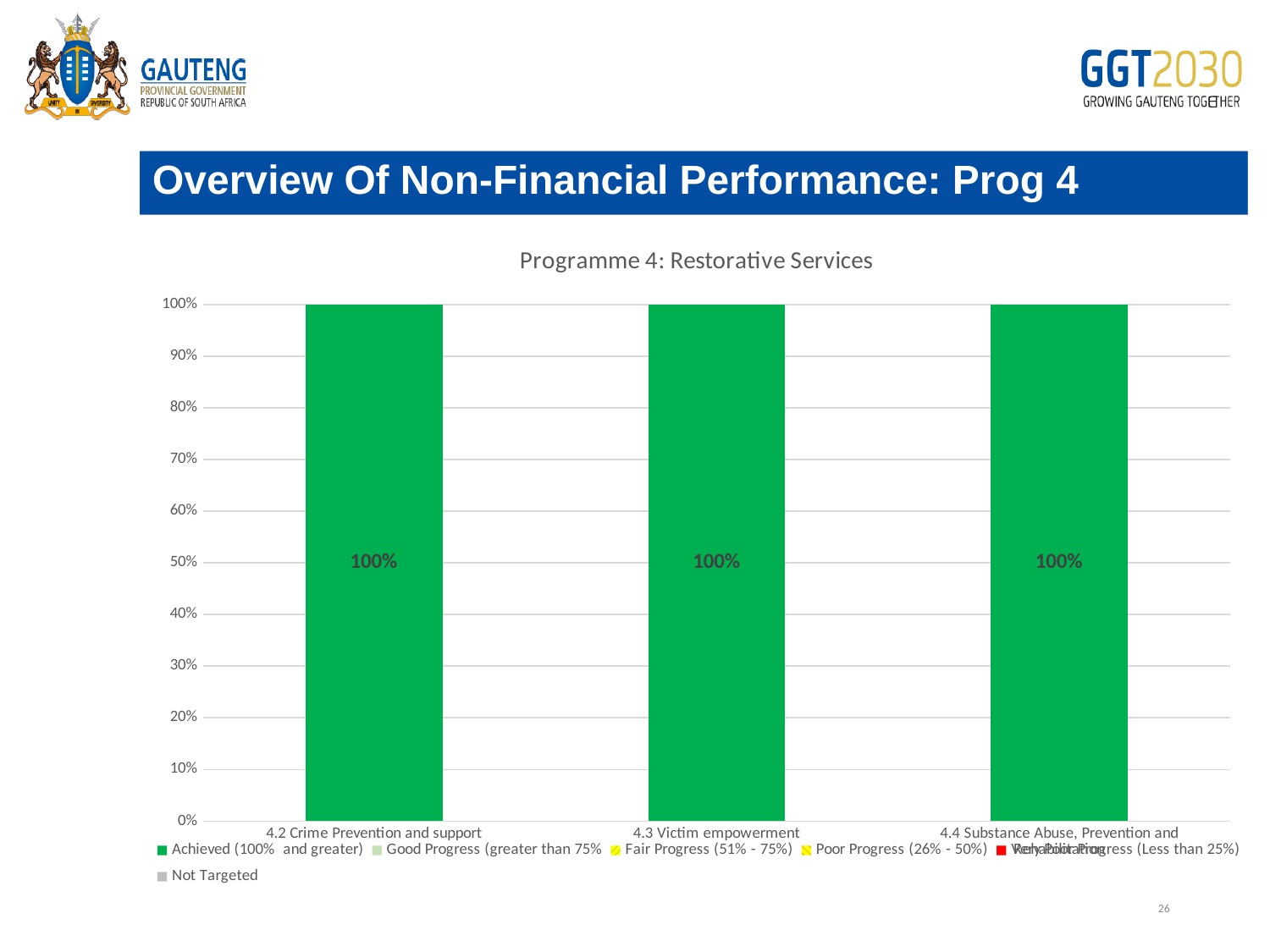
How many series does the legend list? 6 What is the value shown for the 4.4 Substance Abuse, Prevention and Rehabilitation bar? 100% What kind of chart is shown on the slide? Bar chart What is the value shown for 4.2 Crime Prevention and support? 100% Which legend series do all three bars belong to? Achieved (100% and greater) Do the values rise, fall, or stay the same across the categories from left to right? Stay the same What is the value shown for 4.3 Victim empowerment? 100% Is the value for 4.3 Victim empowerment greater or less than 50%? greater What is the title of the chart? Programme 4: Restorative Services What is the total of the stacked bar for 4.2 Crime Prevention and support? 100% How many categories are plotted on the x axis? 3 What is the difference between the values for 4.2 Crime Prevention and support and 4.3 Victim empowerment? 0%